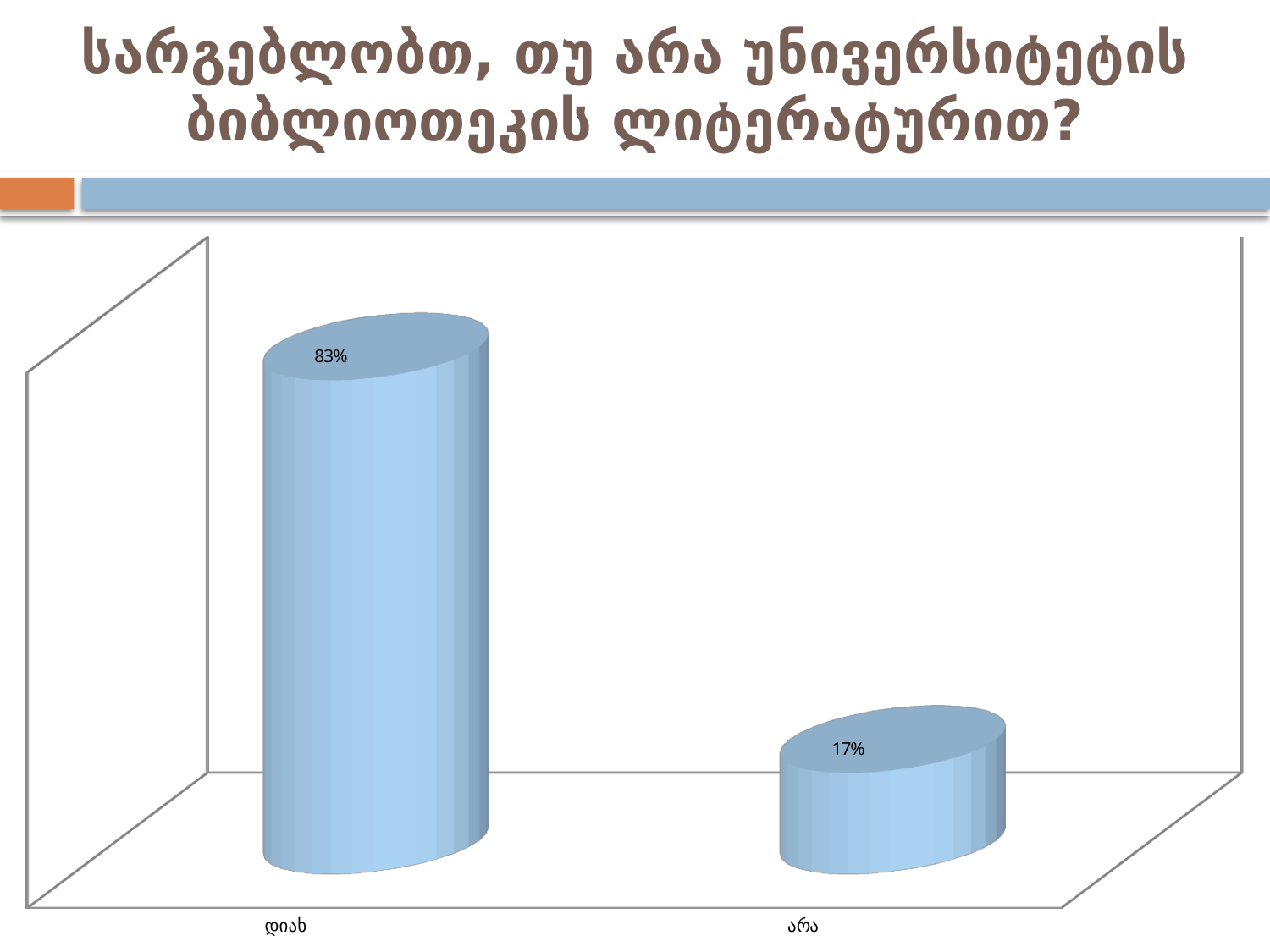
What is the difference between the values for დიახ and არა? 66% What is the value for დიახ? 83% What colour are the bars in the chart? light blue How many categories are shown in the chart? 2 Which category has the highest value? დიახ Which is larger, the value for დიახ or the value for არა? დიახ Do the values rise or fall from left to right along the x axis? fall Which category has the lowest value? არა What is the title of the slide? სარგებლობთ, თუ არა უნივერსიტეტის ბიბლიოთეკის ლიტერატურით? What is the value for არა? 17% What kind of chart is shown on the slide? bar chart What is the total of the two values shown in the chart? 100%